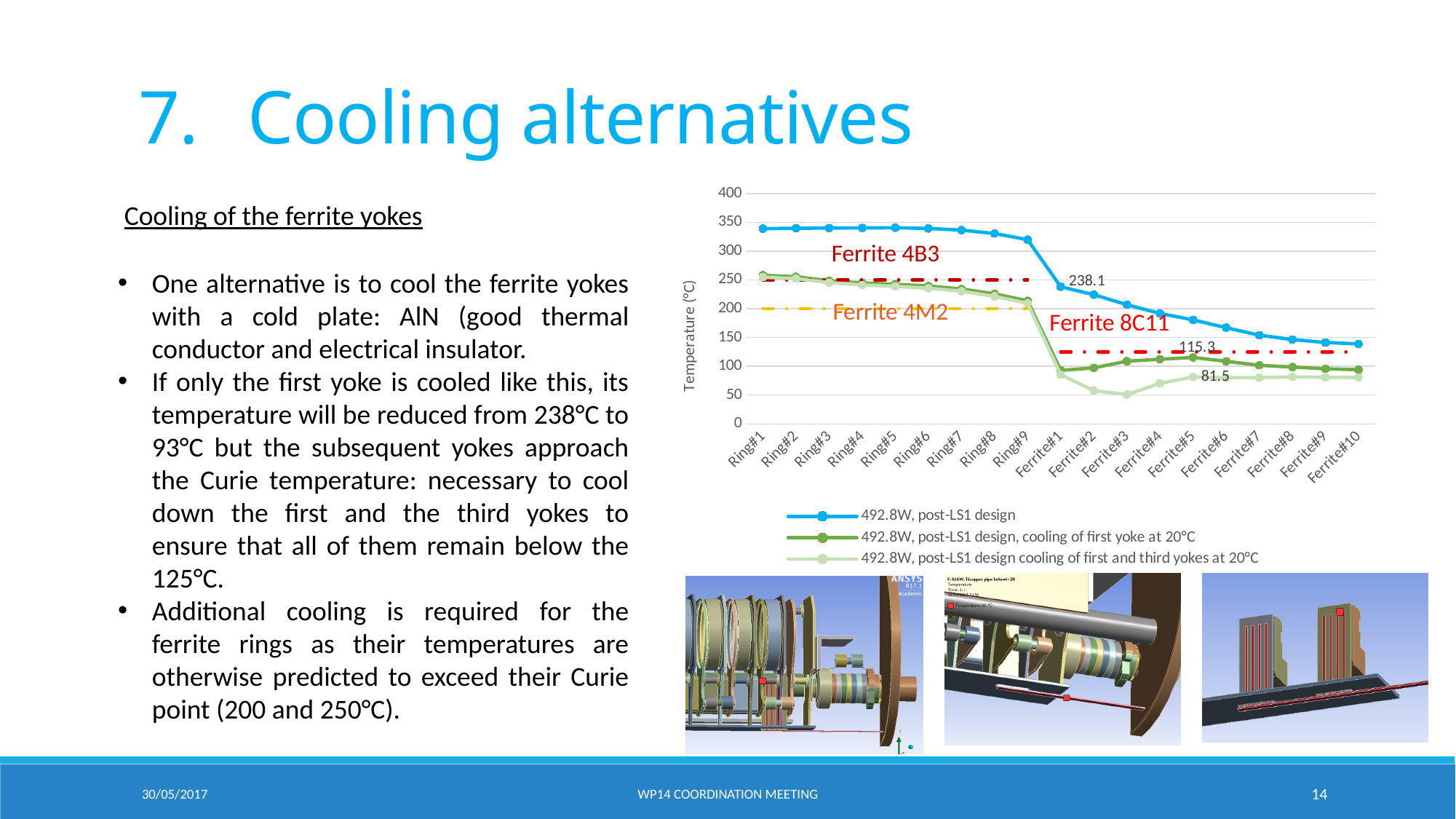
What is the difference between the labelled values 115.3 and 81.5 at Ferrite#5? 33.8 What is the labelled value for Ferrite#5 in the '492.8W, post-LS1 design, cooling of first yoke at 20°C' series? 115.3 What is the label of the y axis of the chart? Temperature (°C) What kind of chart is shown on the slide? line chart What is the labelled value for Ferrite#5 in the '492.8W, post-LS1 design cooling of first and third yokes at 20°C' series? 81.5 How many series does the chart legend list? 3 Which series has the highest value at Ring#1? 492.8W, post-LS1 design What is the labelled value for Ferrite#1 in the '492.8W, post-LS1 design' series? 238.1 Is the value for Ferrite#10 in the '492.8W, post-LS1 design' series greater or less than 200? less How many categories are shown on the x axis of the chart? 19 Does the '492.8W, post-LS1 design' series rise or fall from Ferrite#1 to Ferrite#10? fall Is the value for Ring#1 in the '492.8W, post-LS1 design' series greater or less than 300? greater